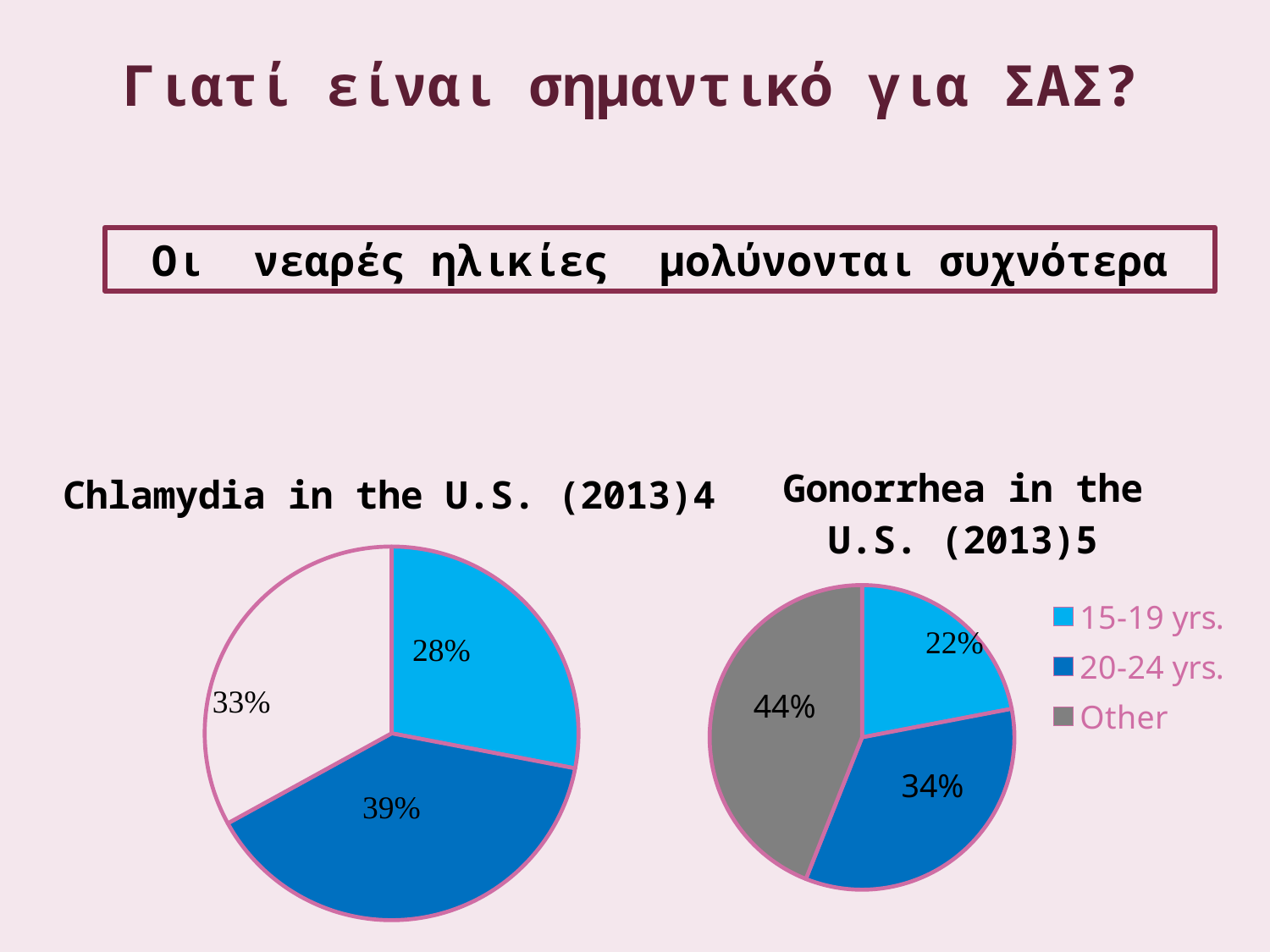
In the Gonorrhea in the U.S. (2013) chart, which slice is the smallest? 15-19 yrs. In the Gonorrhea in the U.S. (2013) chart, what share is shown for the 15-19 yrs. slice? 22% How many entries does the legend next to the Gonorrhea in the U.S. (2013) chart list? 3 In the Chlamydia in the U.S. (2013) chart, what share is shown for the 20-24 yrs. slice? 39% In the Chlamydia in the U.S. (2013) chart, what percentage is shown on the white slice? 33% What kind of chart is used for Chlamydia in the U.S. (2013)? Pie chart In the Gonorrhea in the U.S. (2013) chart, what share is shown for the 20-24 yrs. slice? 34% In the Chlamydia in the U.S. (2013) chart, which slice is the largest? 20-24 yrs. In the Gonorrhea in the U.S. (2013) chart, what is the difference between the Other slice and the 15-19 yrs. slice? 22% In the Chlamydia in the U.S. (2013) chart, what share is shown for the 15-19 yrs. slice? 28% In the Gonorrhea in the U.S. (2013) chart, what share is shown for the Other slice? 44% In the Gonorrhea in the U.S. (2013) chart, which slice is the largest? Other